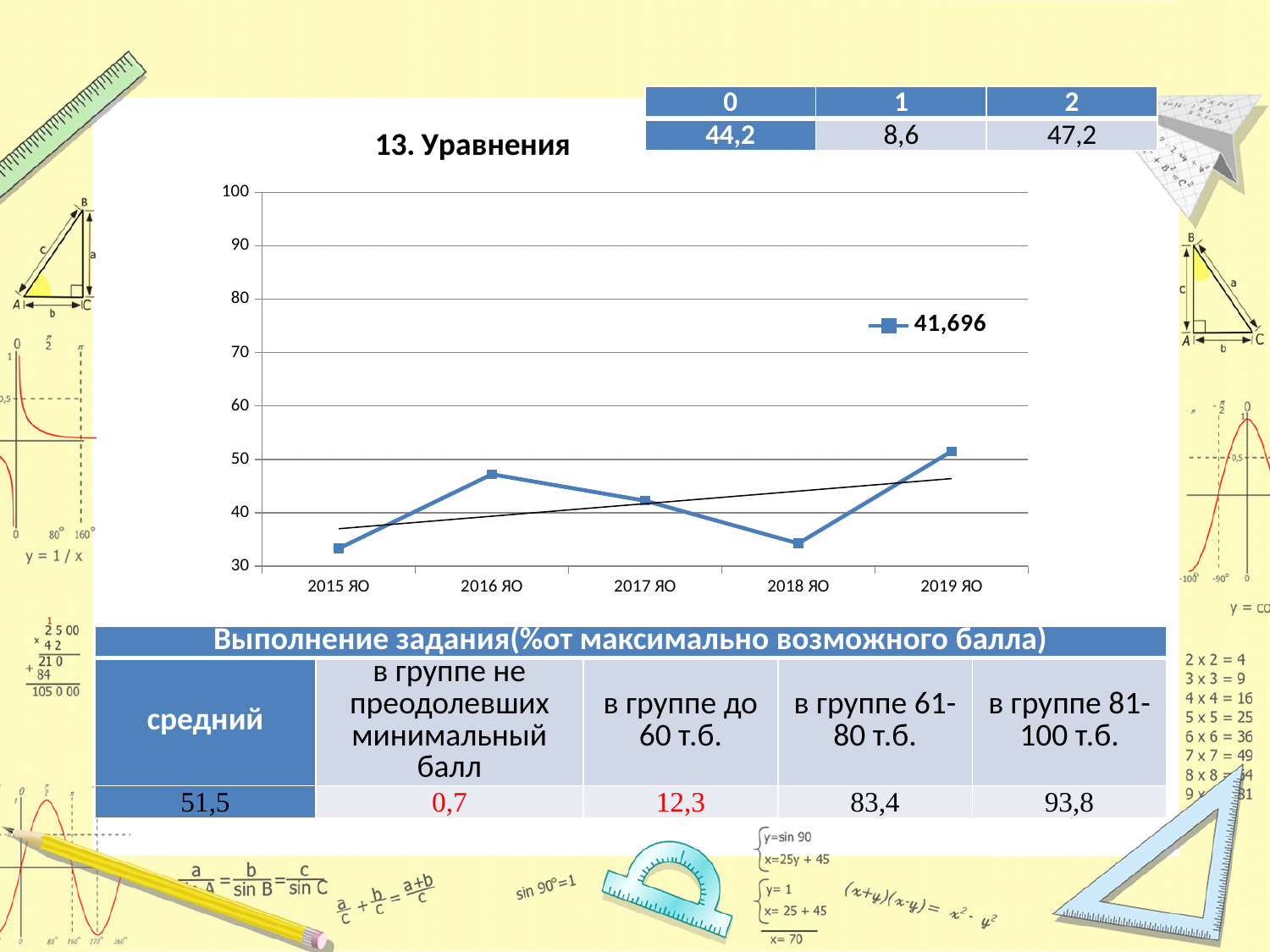
Is the value for 2019 ЯО greater or less than 50? greater Is the value for 2016 ЯО greater or less than 40? greater What kind of chart is shown on the slide? line chart How many categories are shown on the x axis of the chart? 5 Which year has the highest value in the chart? 2019 ЯО Is the value for 2015 ЯО greater or less than 40? less What is the title of the chart? 13. Уравнения Which is larger, the value for 2016 ЯО or the value for 2018 ЯО? 2016 ЯО How many series does the chart legend list? 1 Which is larger, the value for 2019 ЯО or the value for 2017 ЯО? 2019 ЯО What is the legend entry shown in the chart? 41,696